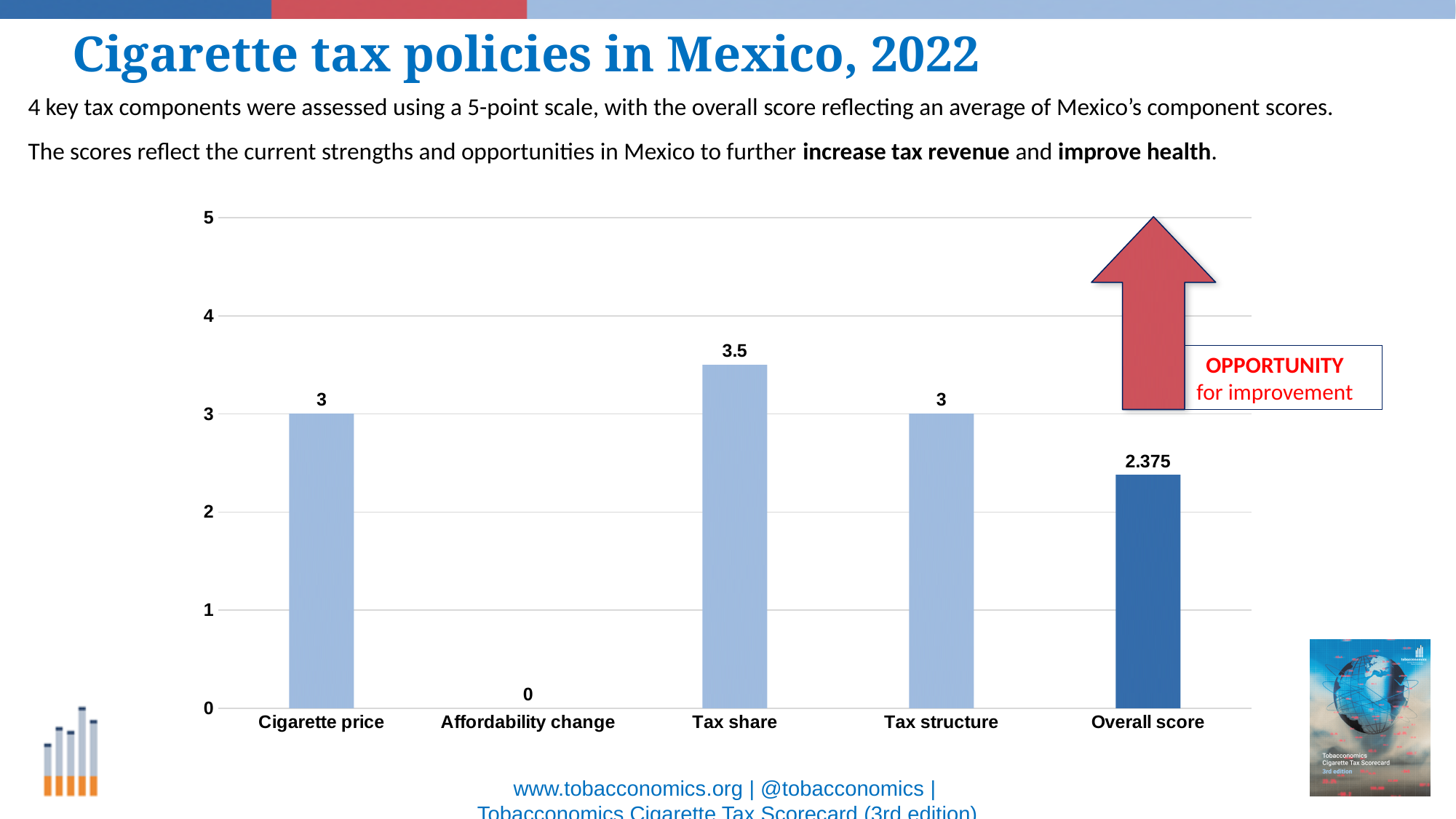
What is the value for Cigarette price? 3 What is the difference between the values for Tax share and Tax structure? 0.5 Which category has the highest value? Tax share Which category has the lowest value? Affordability change What is the difference between the values for Cigarette price and Overall score? 0.625 What is the value for Affordability change? 0 What kind of chart is shown on the slide? Bar chart Which is larger, the value for Tax share or the value for Overall score? Tax share What is the value for Overall score? 2.375 How many categories are shown on the x axis? 5 What is the maximum value shown on the y axis? 5 What is the value for Tax share? 3.5